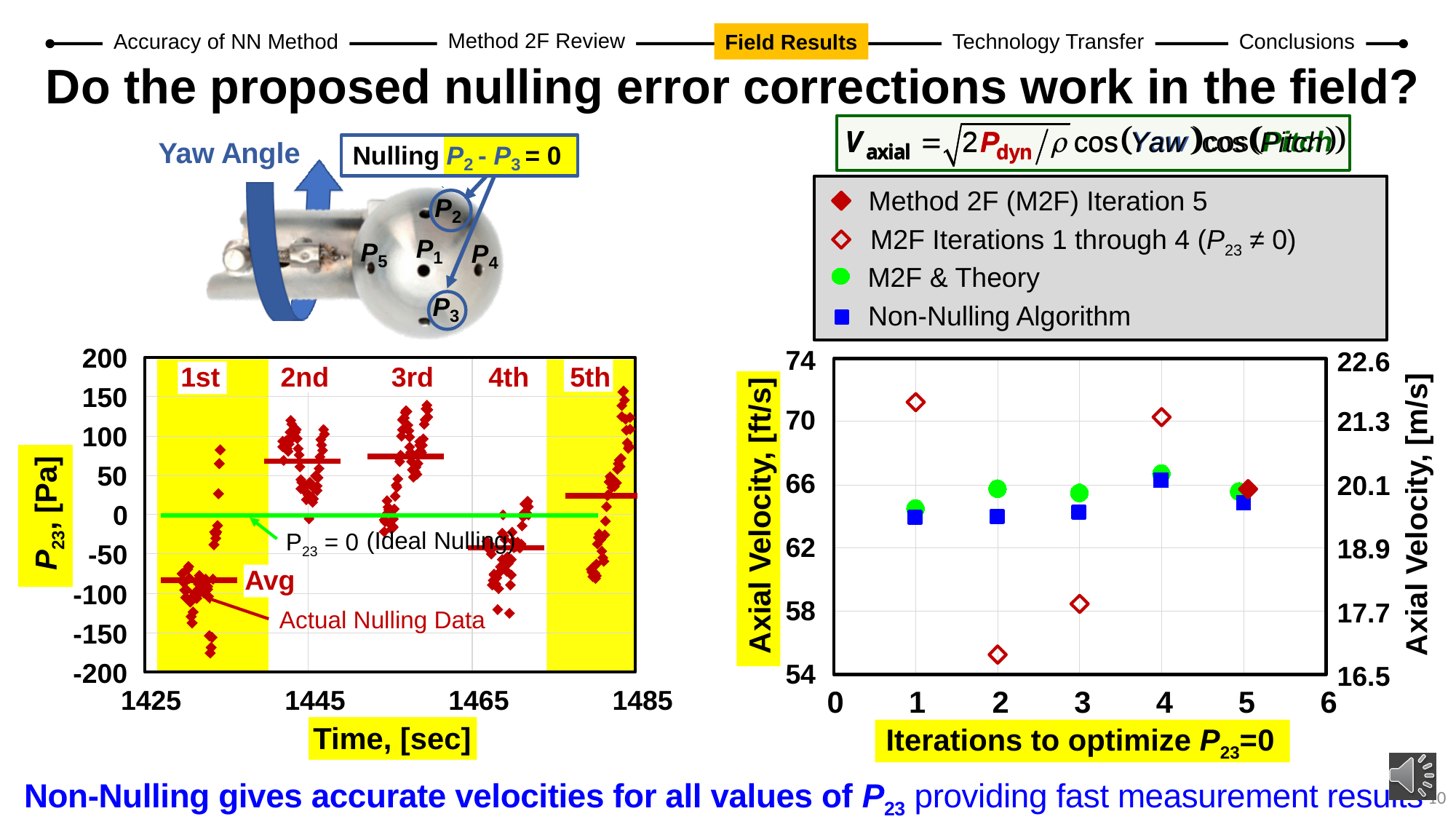
On the right chart (Axial Velocity vs Iterations), how many series does the legend list? 4 On the right chart, which is larger at iteration 2: the M2F & Theory value or the M2F Iterations 1 through 4 value? M2F & Theory What kind of chart is the right chart showing Axial Velocity against Iterations to optimize P23=0? scatter chart On the right chart, what is the label of the right vertical axis? Axial Velocity, [m/s] On the left chart (P23 vs Time), how many nulling iterations (1st through 5th) are marked? 5 On the right chart, is the M2F Iterations 1 through 4 value at iteration 1 greater or less than 70 ft/s? greater On the right chart, at which iteration is the M2F Iterations 1 through 4 (open diamond) value lowest? 2 On the right chart, what is the label of the left vertical axis? Axial Velocity, [ft/s] On the right chart, is the M2F Iterations 1 through 4 value at iteration 3 greater or less than 62 ft/s? less On the left chart (P23 vs Time), which nulling iteration has the lowest average P23? 1st On the right chart, is the M2F Iterations 1 through 4 value at iteration 2 greater or less than 58 ft/s? less